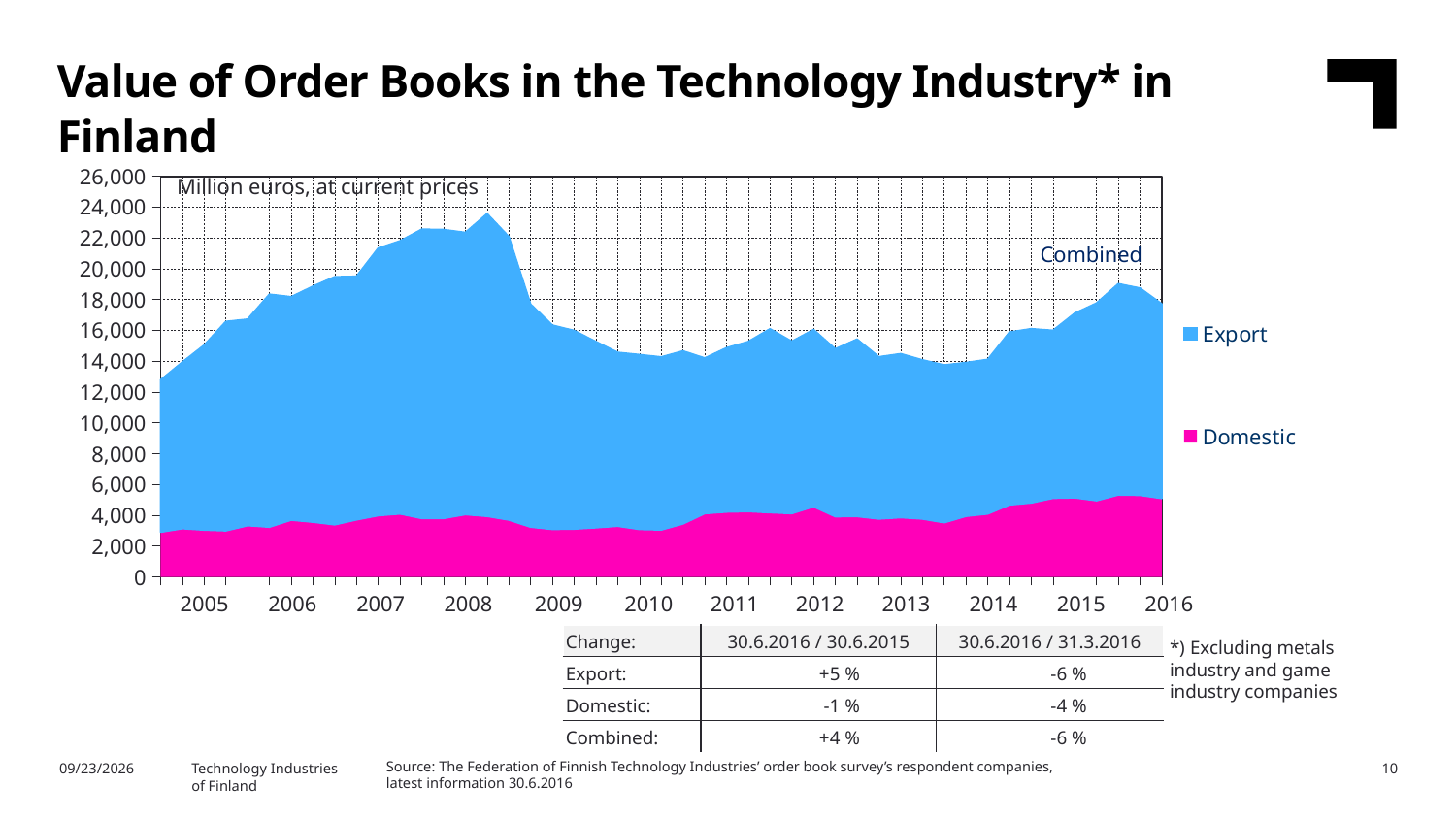
In the table below the chart, what is the Export change for 30.6.2016 / 30.6.2015? +5 % Is the combined value in 2010 greater or less than 16,000? less How many series does the legend list? 2 What are the two series named in the legend? Export and Domestic How many years are labelled on the x axis? 12 Is the combined value at its 2008 peak greater or less than 22,000? greater Which series is larger throughout the chart, Export or Domestic? Export Is the Domestic value at the end of the chart in 2016 greater or less than 4,000? greater What kind of chart is shown on the slide? Stacked area chart What unit is stated in the chart's subtitle? Million euros, at current prices Does the combined value rise or fall between the 2008 peak and 2009? fall